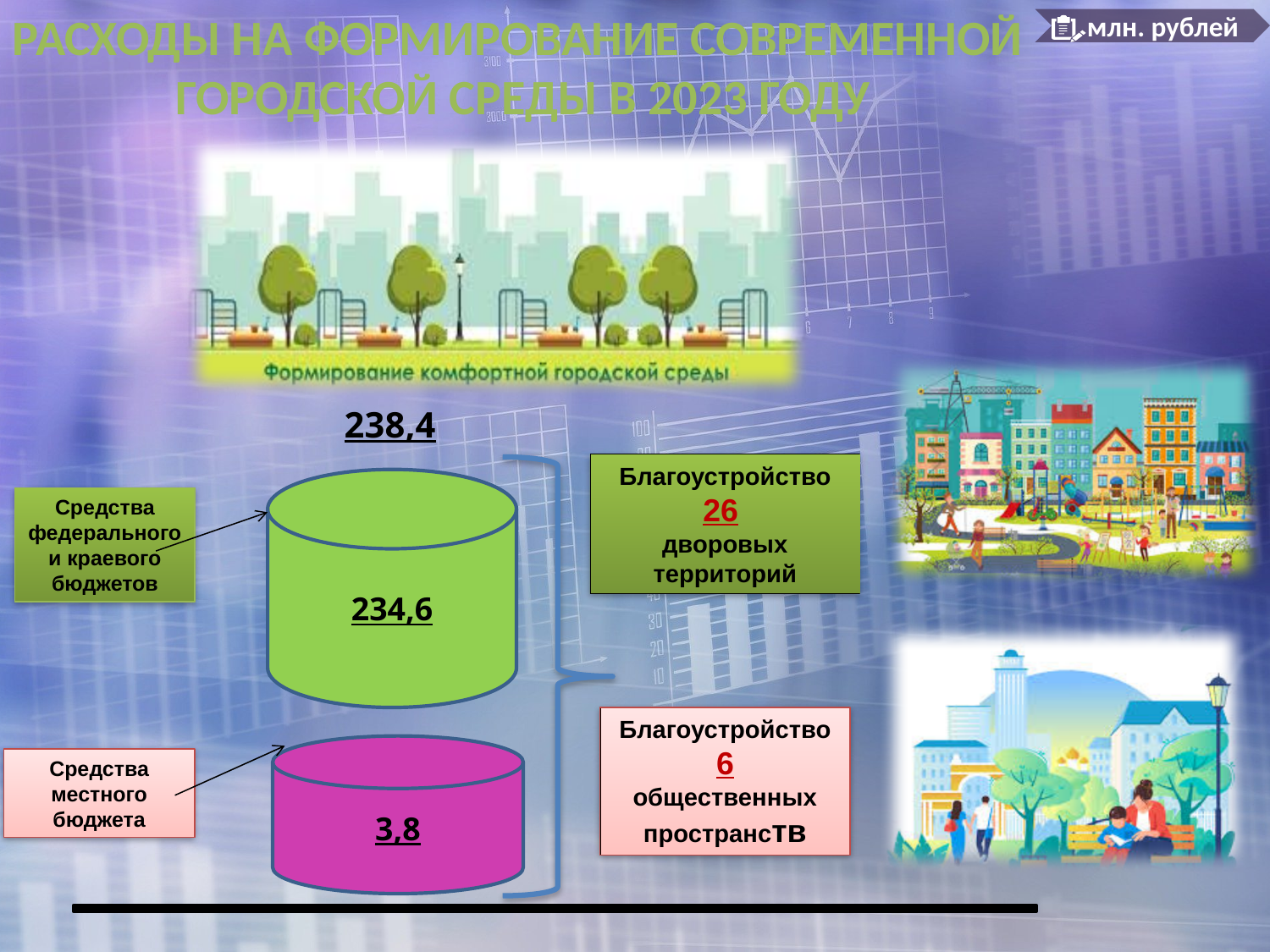
What is the difference between the federal/regional budget funds and the local budget funds? 230,8 How many courtyard territories (дворовых территорий) are shown as improved? 26 How many funding sources (cylinders) are shown on the slide? 2 What value is shown for the funds from the federal and regional budgets (Средства федерального и краевого бюджетов)? 234,6 What total amount is shown above the two cylinders? 238,4 What colour is the cylinder representing the local budget funds? Magenta (pink) Which funding source has the larger value: the federal and regional budgets or the local budget? Средства федерального и краевого бюджетов How many public spaces (общественных пространств) are shown as improved? 6 Which funding source has the smallest value? Средства местного бюджета In what units are the values on the slide expressed, according to the label in the top right corner? млн. рублей What value is shown for the funds from the local budget (Средства местного бюджета)? 3,8